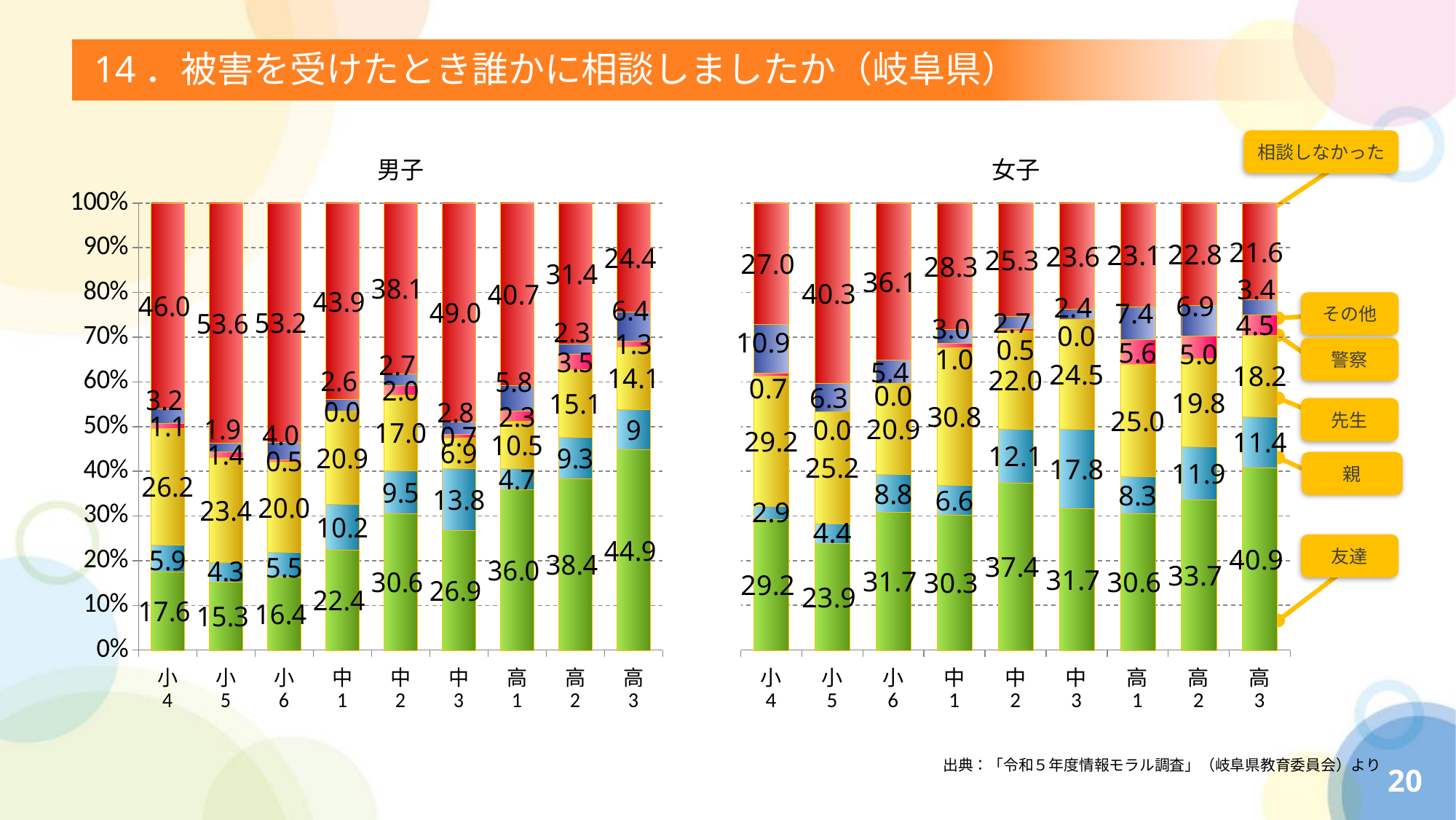
In the 男子 chart, which grade has the highest value for 友達? 高3 In the 男子 chart, what is the value of 相談しなかった for 小4? 46.0 In the 女子 chart, what is the value of 親 for 中3? 24.5 In the 女子 chart, which is larger, the 友達 value for 中2 or for 高3? 高3 In the 女子 chart, what is the value of 友達 for 高3? 40.9 What kind of chart is the 女子 chart? Stacked bar chart How many grade categories are shown on the x axis of the 男子 chart? 9 In the 男子 chart, which grade has the lowest value for 相談しなかった? 高3 In the 男子 chart, what is the value of 先生 for 中1? 10.2 In the 女子 chart, which grade has the highest value for 相談しなかった? 小5 In the 男子 chart, what is the difference between the 友達 value for 高3 and for 小4? 27.3 How many series (response options) are listed in the legend on the right of the slide? 6